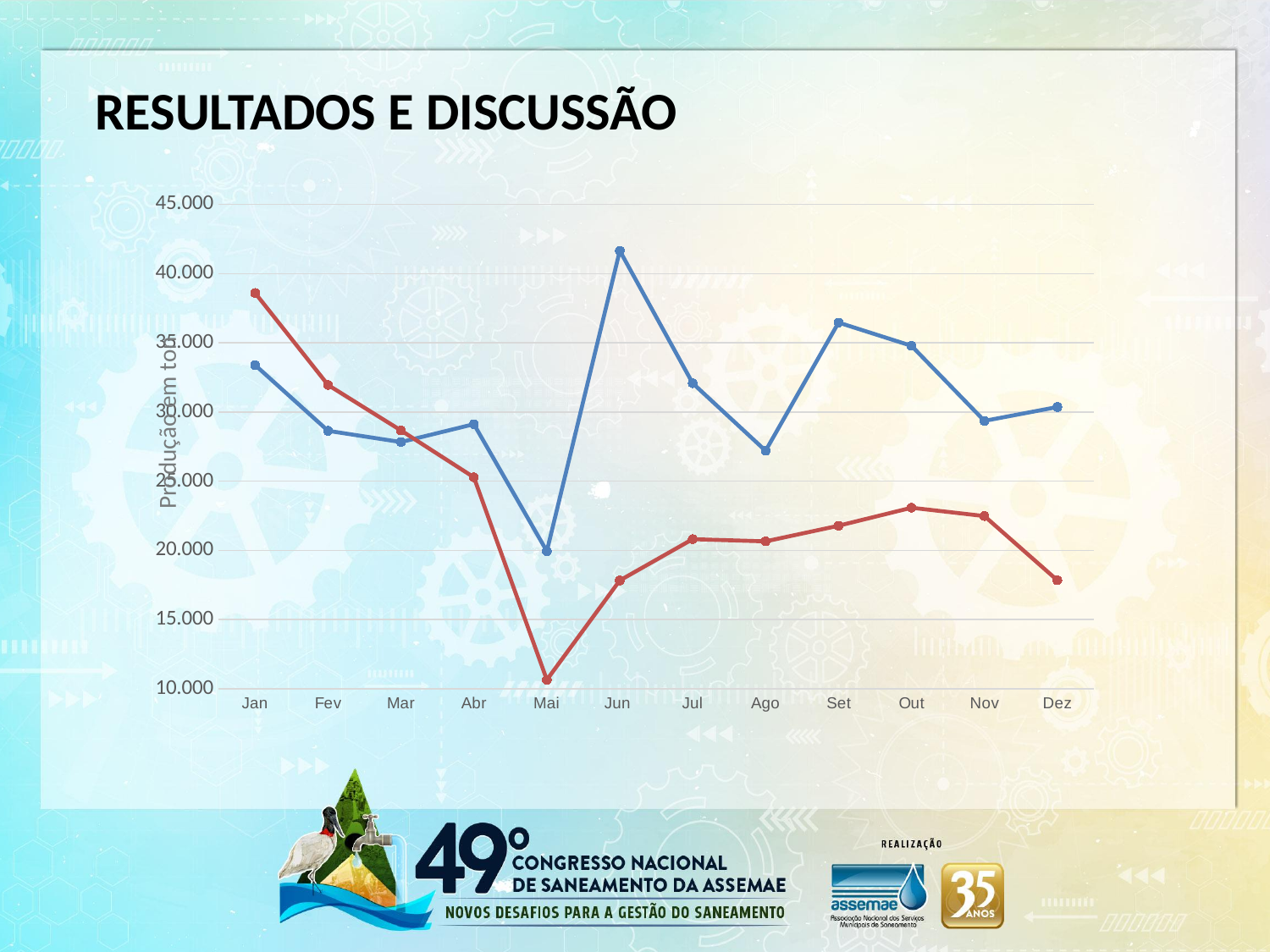
What kind of chart is shown on the slide? line chart Does the red line rise or fall from Jan to Mai? fall Is the value of the blue line in Jun greater or less than 40.000? greater In which month does the blue line reach its lowest value? Mai In Jan, which line has the higher value, the blue line or the red line? the red line Is the value of the red line in Jan greater or less than 35.000? greater How many lines are plotted on the chart? 2 Is the value of the red line in Dez greater or less than 20.000? less How many months are shown on the x axis of the chart? 12 In which month does the red line reach its highest value? Jan In which month does the blue line reach its highest value? Jun In which month does the red line reach its lowest value? Mai